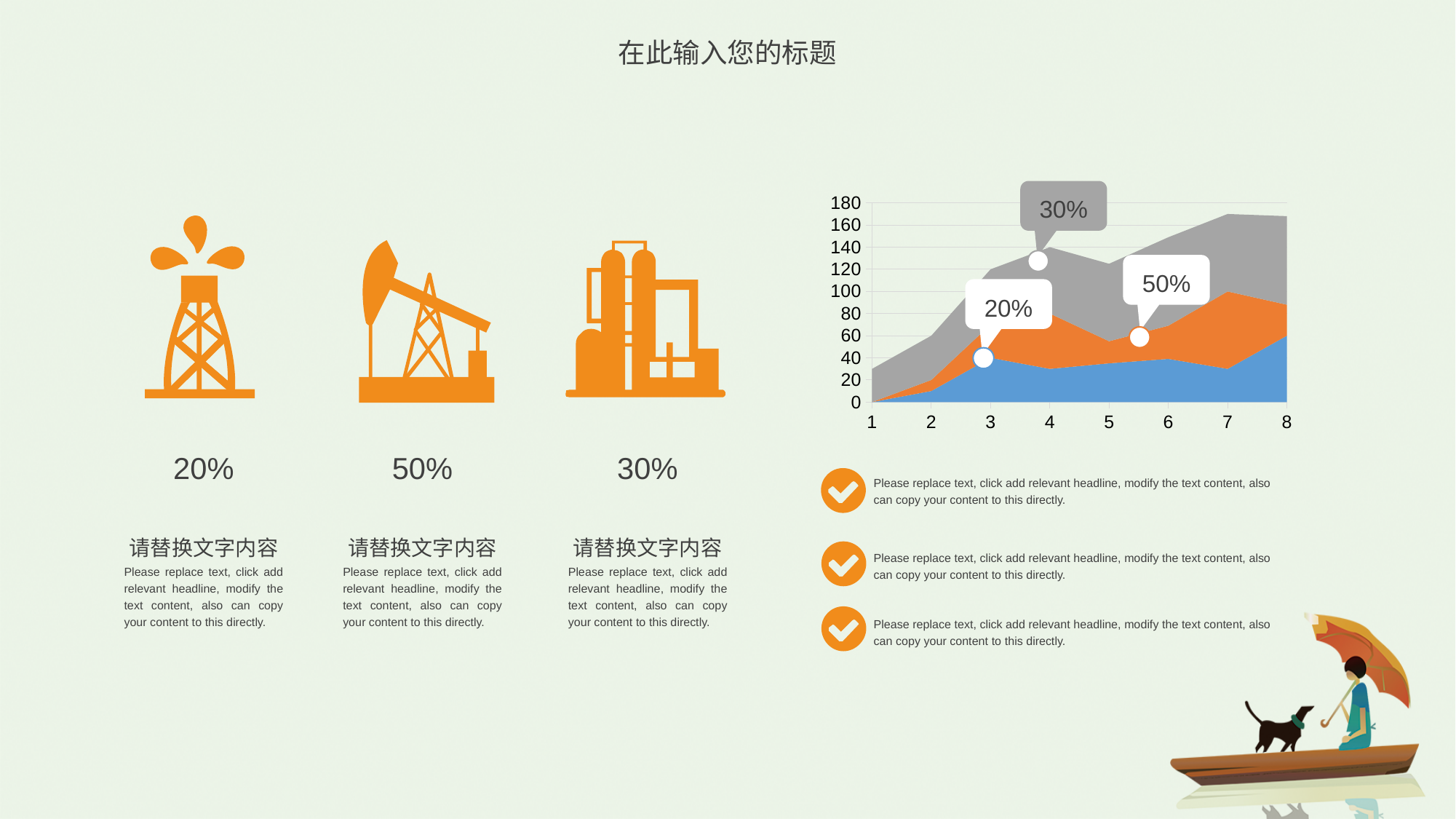
Is the total height of the stacked area at x = 2 greater or less than 80? less Is the total height of the stacked area at x = 4 greater or less than 100? greater Which has the greater total stacked height, x = 2 or x = 3? 3 What kind of chart is shown on the right of the slide? area chart At which x-axis point is the total height of the stacked area lowest? 1 What is the highest value shown on the y axis of the area chart? 180 How many points are labelled along the x axis of the area chart? 8 Does the total height of the stacked area rise or fall from x = 1 to x = 4? rise Is the total height of the stacked area at x = 1 greater or less than 40? less What percentage is shown in the gray callout above the area chart? 30% How many coloured series are stacked in the area chart? 3